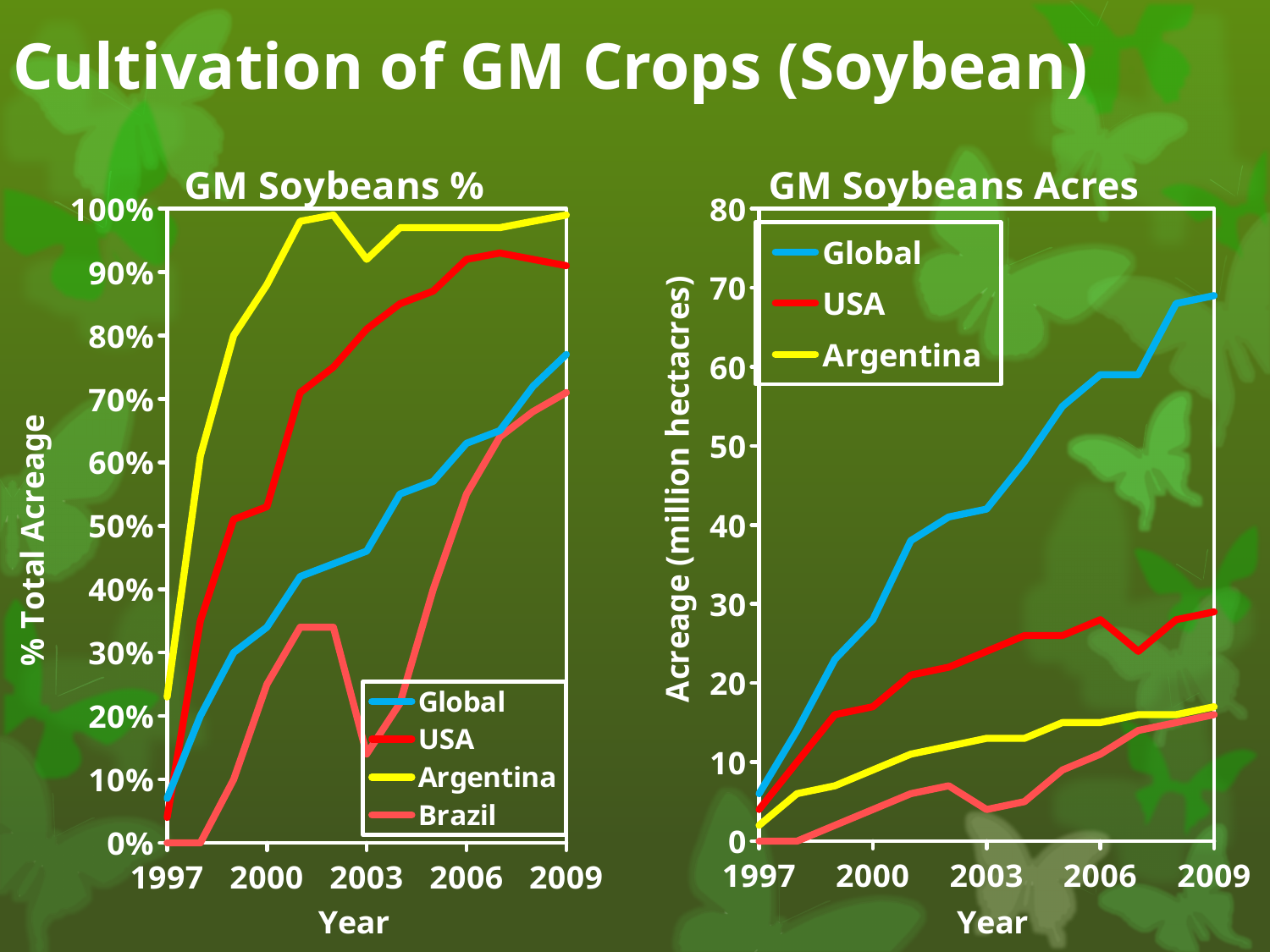
In the "GM Soybeans Acres" chart, is the value for Argentina in 2009 greater or less than 20? less How many series does the legend of the "GM Soybeans Acres" chart list? 3 In the "GM Soybeans %" chart, which series has the lowest value in 2009? Brazil What kind of chart is the "GM Soybeans %" chart on the left? line chart In the "GM Soybeans Acres" chart, which is larger in 2009, USA or Argentina? USA How many series does the legend of the "GM Soybeans %" chart list? 4 In the "GM Soybeans %" chart, is the value for Argentina in 2009 greater or less than 90%? greater In the "GM Soybeans Acres" chart, is the value for Global in 2009 greater or less than 60? greater What is the y-axis label of the "GM Soybeans Acres" chart? Acreage (million hectacres) In the "GM Soybeans %" chart, which series has the highest value in 2009? Argentina In the "GM Soybeans Acres" chart, does the Global line rise or fall from 1997 to 2009? rise